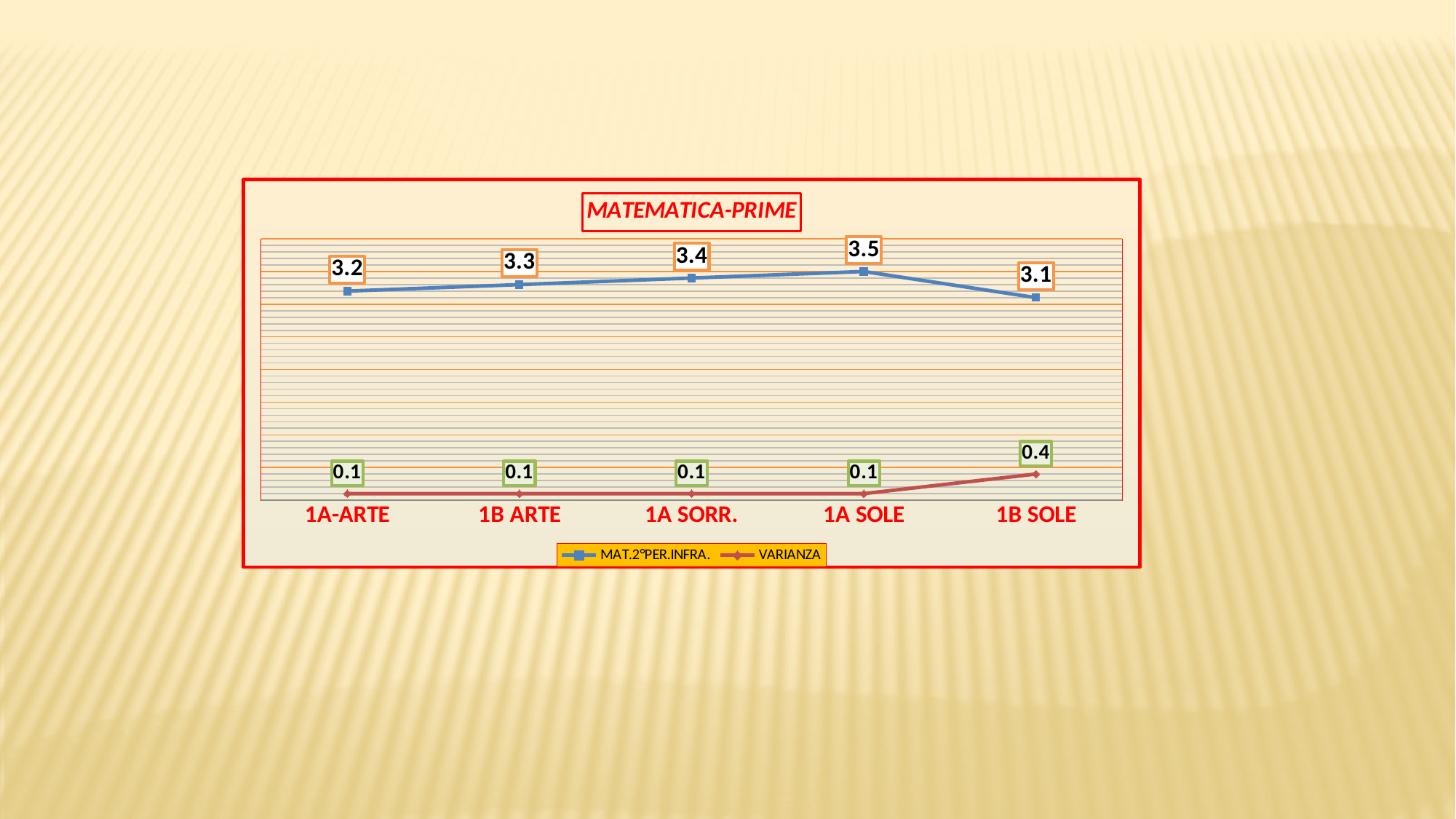
What is the MAT.2°PER.INFRA. value for 1A SORR.? 3.4 Which category has the highest MAT.2°PER.INFRA. value? 1A SOLE How many series does the legend list? 2 Which category has the highest VARIANZA value? 1B SOLE What is the title of the chart? MATEMATICA-PRIME Does the MAT.2°PER.INFRA. line rise or fall from 1A-ARTE to 1A SOLE? rise Which category has the lowest MAT.2°PER.INFRA. value? 1B SOLE How many categories are shown on the x axis? 5 What is the difference between the MAT.2°PER.INFRA. values for 1A SOLE and 1B SOLE? 0.4 Which is larger, the MAT.2°PER.INFRA. value for 1A-ARTE or for 1B ARTE? 1B ARTE What is the VARIANZA value for 1B SOLE? 0.4 What type of chart is shown on the slide? line chart